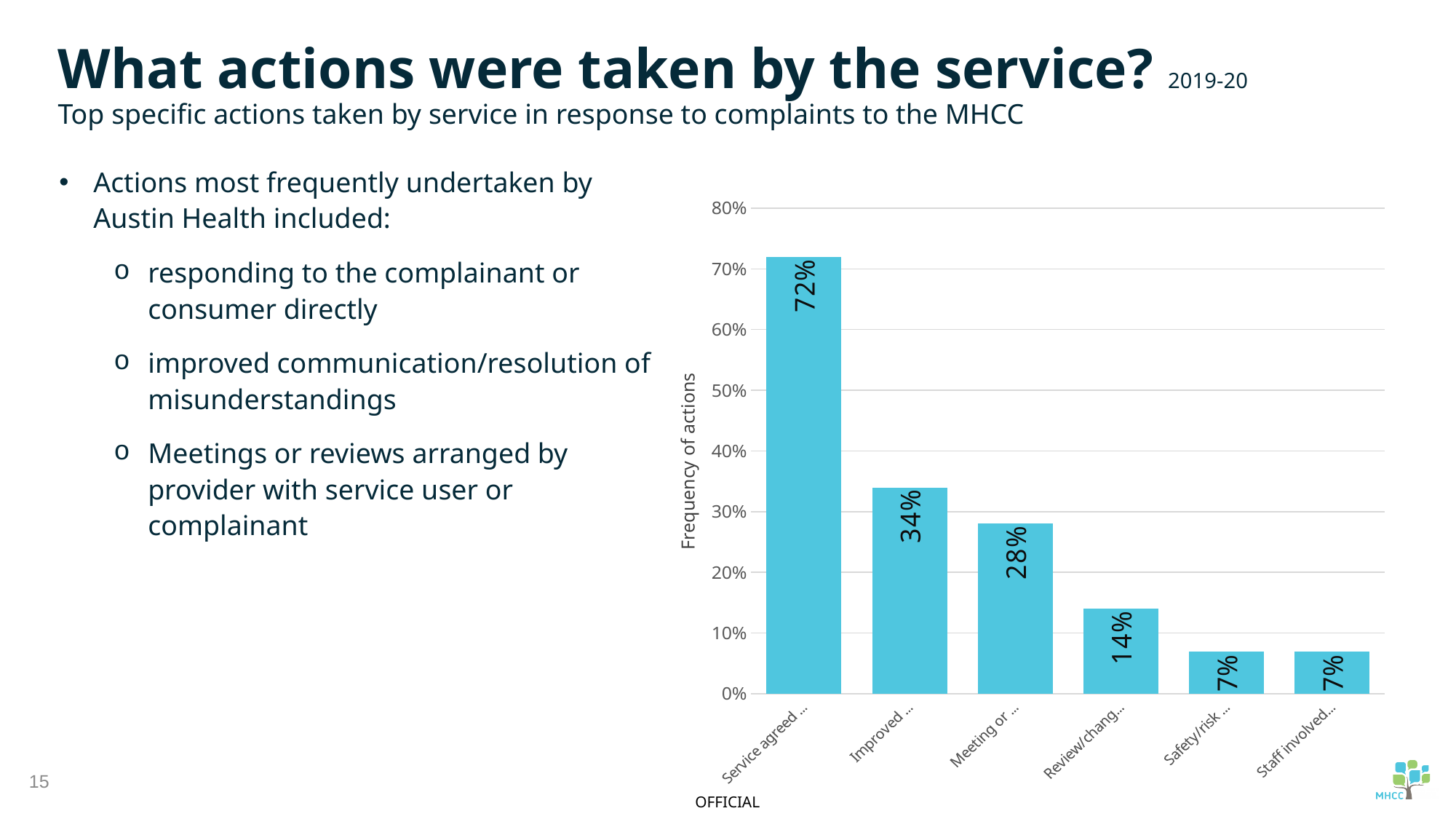
What is the difference between the values for "Meeting or ..." and "Review/chang..."? 14% Which category has the highest frequency of actions? Service agreed ... Is the value for "Service agreed ..." greater or less than 70%? greater What kind of chart is shown on the slide? bar chart What is the value of the bar labelled "Improved ..."? 34% Which is larger, the value for "Improved ..." or the value for "Meeting or ..."? Improved ... What is the label on the vertical axis of the chart? Frequency of actions What is the value of the bar labelled "Service agreed ..."? 72% Do the bar values rise or fall from left to right along the x axis? fall How many bars are shown in the chart? 6 What is the value of the bar labelled "Review/chang..."? 14% What is the difference between the values for "Service agreed ..." and "Improved ..."? 38%